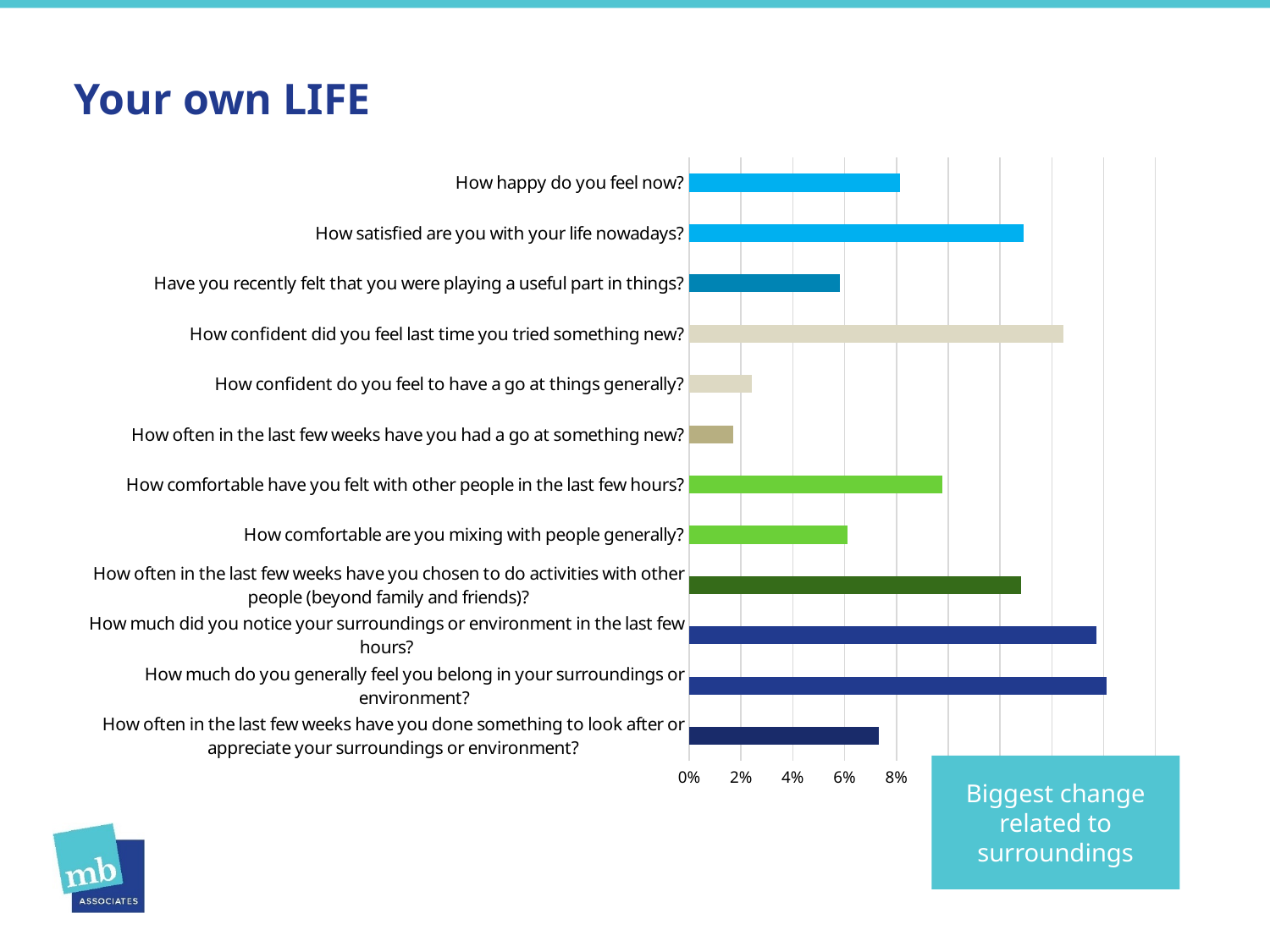
Is the value for "How comfortable have you felt with other people in the last few hours?" greater or less than 8%? greater What kind of chart is shown on the slide? bar chart Is the value for "How often in the last few weeks have you done something to look after or appreciate your surroundings or environment?" greater or less than 6%? greater What does the text box next to the chart's axis say? Biggest change related to surroundings Is the value for "How confident do you feel to have a go at things generally?" greater or less than 4%? less What is the title of the slide containing the chart? Your own LIFE Which is larger: the value for "How satisfied are you with your life nowadays?" or for "How happy do you feel now?" How satisfied are you with your life nowadays? Which category has the shortest bar in the chart? How often in the last few weeks have you had a go at something new? Which is larger: the value for "How confident did you feel last time you tried something new?" or for "How confident do you feel to have a go at things generally?" How confident did you feel last time you tried something new? How many questions (categories) are plotted in the chart? 12